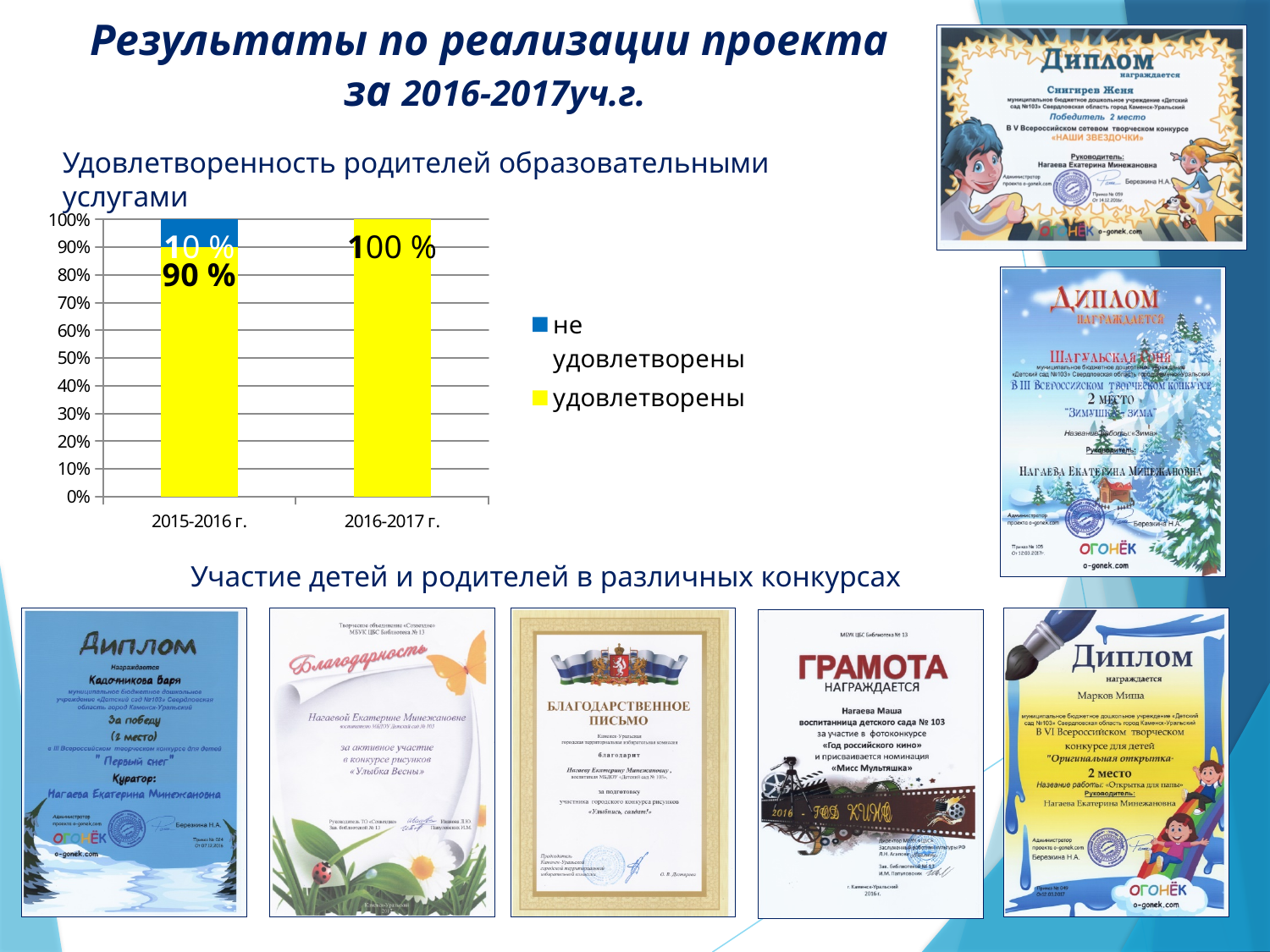
What is the value for "не удовлетворены" in 2015-2016 г.? 10 % Which year has the higher value for "удовлетворены"? 2016-2017 г. What is the value for "удовлетворены" in 2016-2017 г.? 100 % How many categories are shown on the x axis of the chart? 2 What is the value for "удовлетворены" in 2015-2016 г.? 90 % What is the difference between the "удовлетворены" values for 2016-2017 г. and 2015-2016 г.? 10 % What is the total of the stacked bar for 2015-2016 г.? 100 % What kind of chart is shown on the slide? bar chart What is the title of the chart? Удовлетворенность родителей образовательными услугами Which colour represents "удовлетворены" in the chart? yellow How many series does the chart legend list? 2 Does the share of "удовлетворены" rise or fall from 2015-2016 г. to 2016-2017 г.? rise